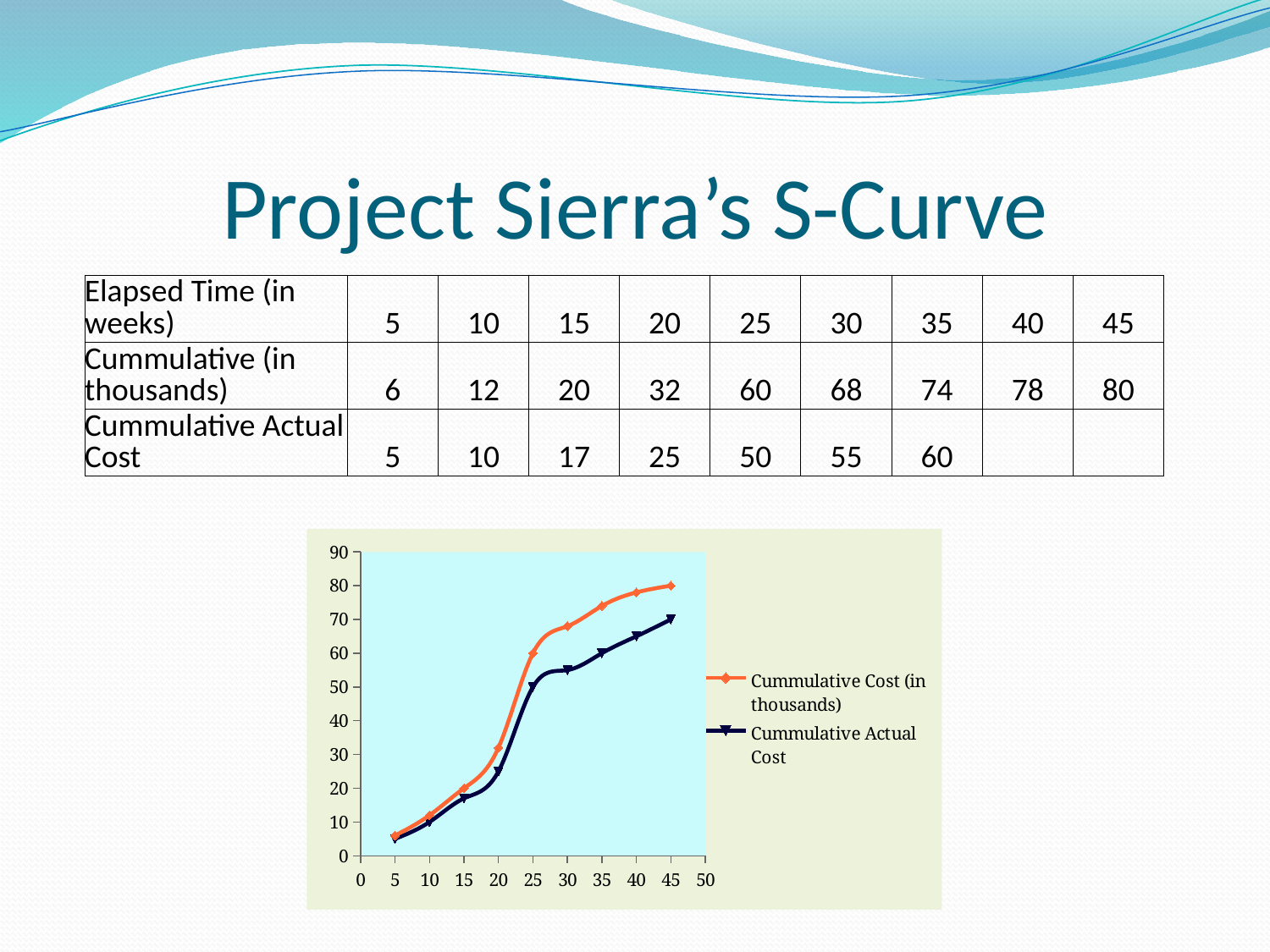
What is the highest value reached by the Cummulative Cost (in thousands) series? 80 Is the Cummulative Cost (in thousands) at 35 weeks greater or less than 70? greater At 25 weeks, what is the difference between Cummulative Cost (in thousands) and Cummulative Actual Cost? 10 What is the Cummulative Cost (in thousands) at 25 weeks? 60 What kind of chart is shown on the slide? line chart At 20 weeks, which series has the larger value, Cummulative Cost (in thousands) or Cummulative Actual Cost? Cummulative Cost (in thousands) Is the value of the Cummulative Actual Cost series at 45 weeks greater or less than 60? greater How many data points are plotted for the Cummulative Cost (in thousands) series? 9 What is the Cummulative Actual Cost at 30 weeks? 55 What are the two series named in the chart's legend? Cummulative Cost (in thousands) and Cummulative Actual Cost Do the values of the Cummulative Cost (in thousands) series rise or fall as elapsed time increases? rise How many series does the chart's legend list? 2